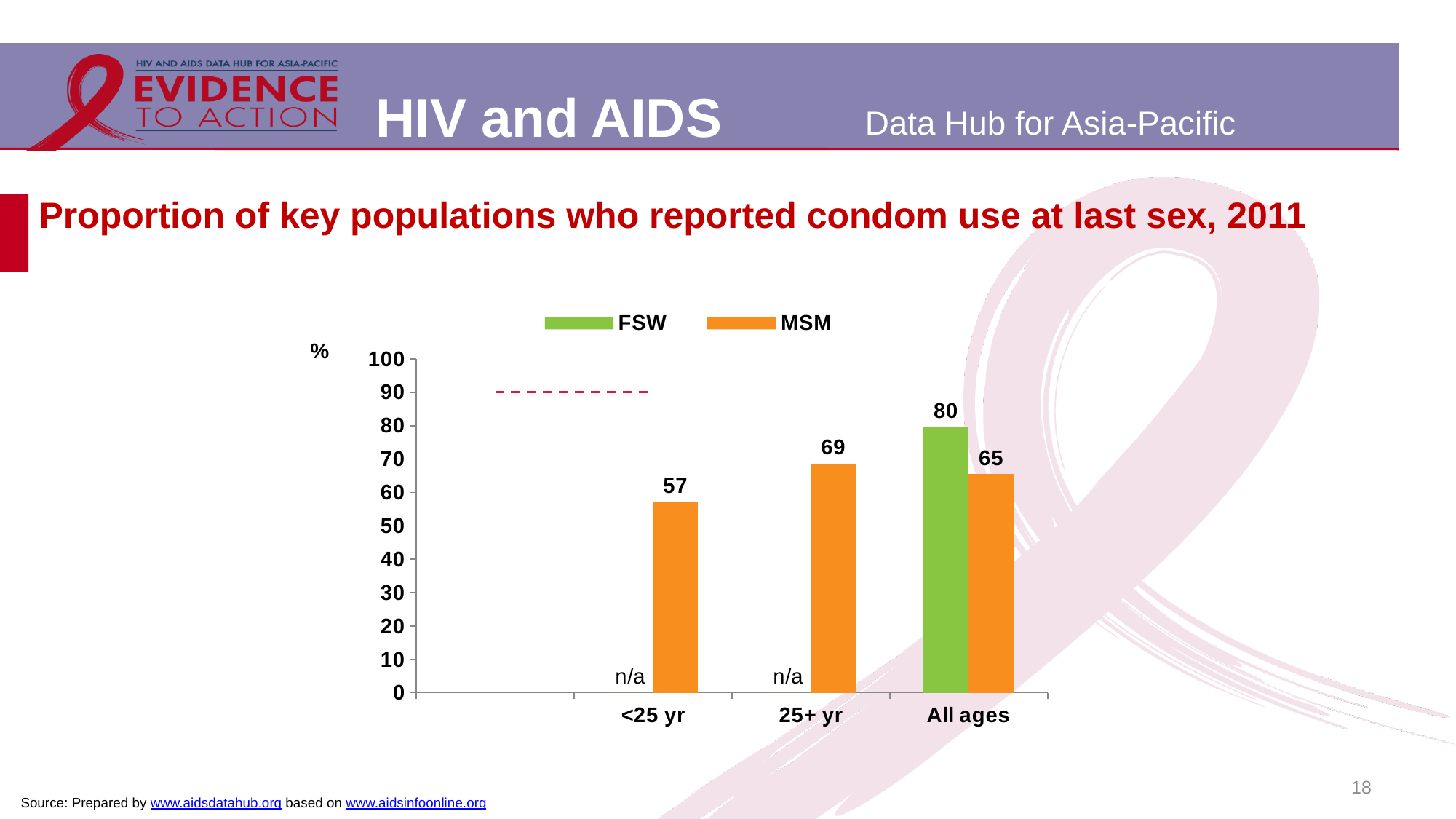
How many series does the legend list? 2 What is the value for MSM in the All ages category? 65 For All ages, which is larger, the FSW value or the MSM value? FSW What is the value for MSM in the 25+ yr category? 69 Which age category has the highest MSM value? 25+ yr What is the value for FSW in the All ages category? 80 What is shown for FSW in the <25 yr and 25+ yr categories? n/a What is the value for MSM in the <25 yr category? 57 What is the difference between the MSM values for 25+ yr and <25 yr? 12 What kind of chart is shown on the slide? Bar chart Which age category has the lowest MSM value? <25 yr What is the difference between the FSW and MSM values for All ages? 15